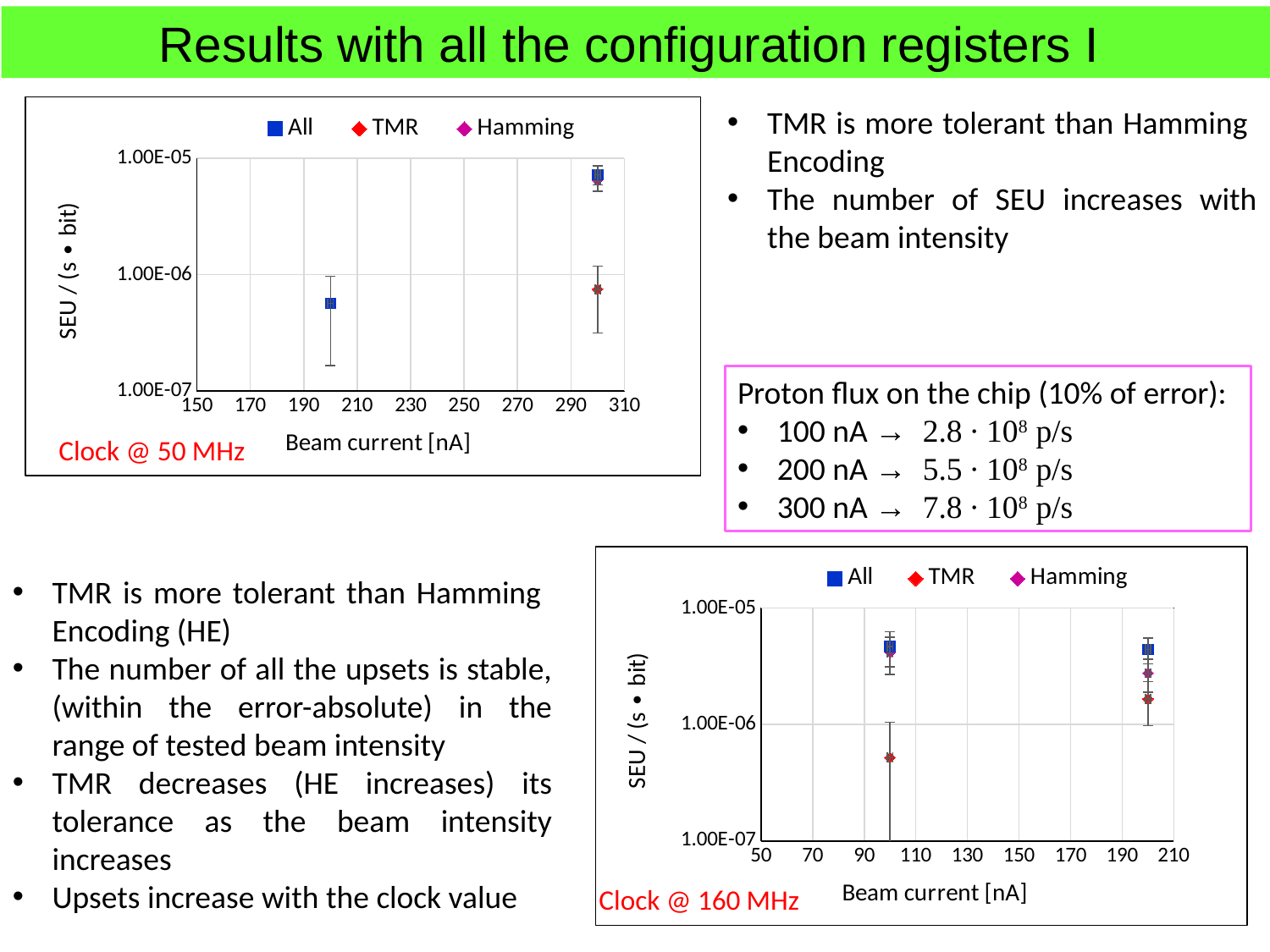
In the Clock @ 160 MHz chart, is the All value at 100 nA greater or less than 1.00E-06? greater How many beam current values have data points plotted in the Clock @ 160 MHz chart? 2 In the Clock @ 50 MHz chart, at 300 nA, which series has the larger SEU value, All or TMR? All What are the legend entries of the Clock @ 160 MHz chart? All, TMR, Hamming In the Clock @ 50 MHz chart, is the All value at 200 nA greater or less than 1.00E-06? less In the Clock @ 160 MHz chart, does the TMR series rise or fall from 100 nA to 200 nA? rise In the Clock @ 50 MHz chart, is the All value at 300 nA greater or less than 1.00E-06? greater In the Clock @ 50 MHz chart, does the All series rise or fall from 200 nA to 300 nA? rise What kind of chart is the top-left chart labelled Clock @ 50 MHz? scatter chart How many series does the legend of the Clock @ 50 MHz chart list? 3 What is the x-axis label of the Clock @ 50 MHz chart? Beam current [nA]